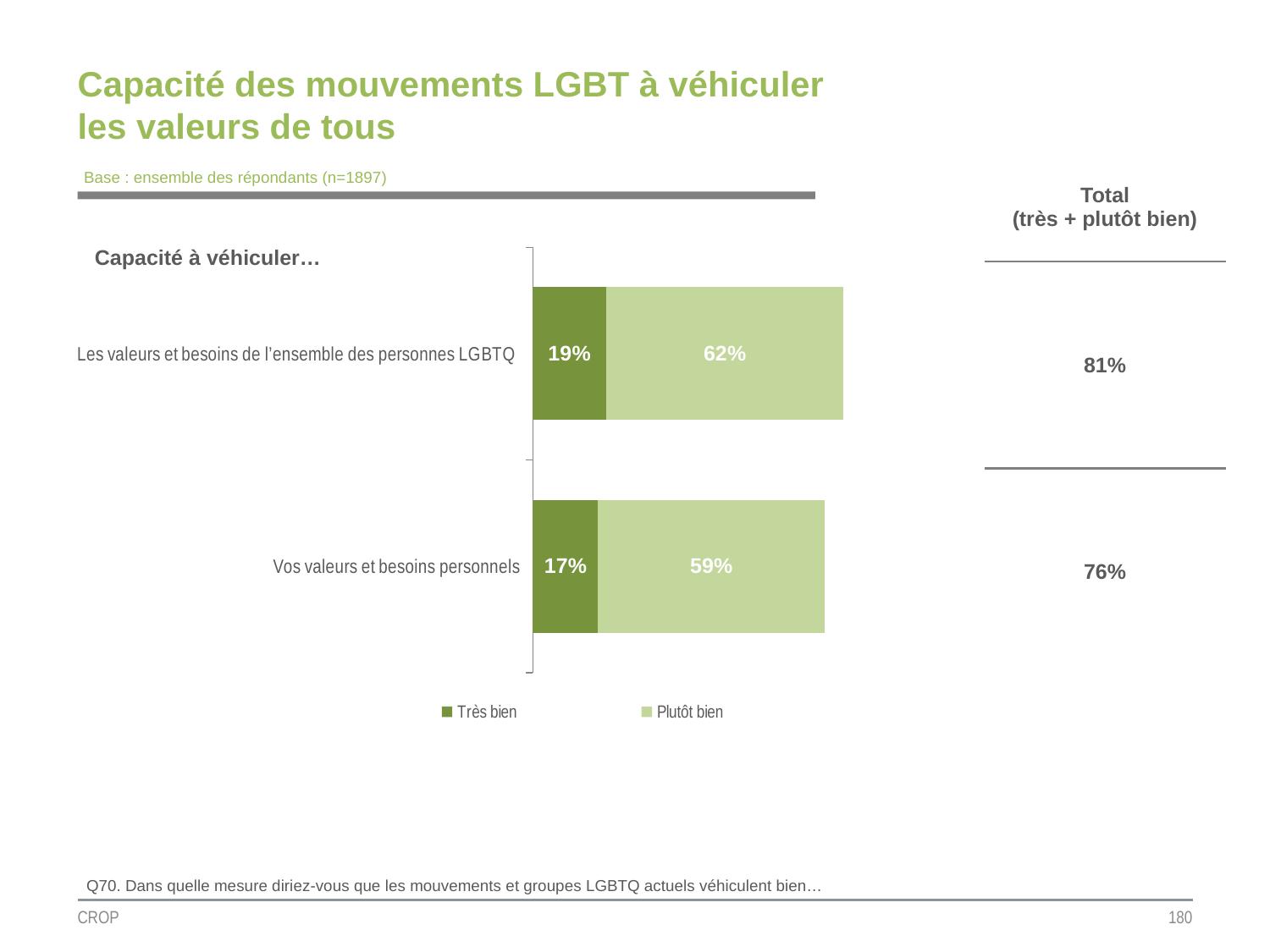
What is the 'Plutôt bien' value for 'Les valeurs et besoins de l'ensemble des personnes LGBTQ'? 62% What is the difference between the 'Plutôt bien' values of the two categories? 3 percentage points What is the total (très + plutôt bien) for 'Les valeurs et besoins de l'ensemble des personnes LGBTQ'? 81% How many categories are shown in the chart? 2 How many series does the legend list? 2 What is the 'Très bien' value for 'Les valeurs et besoins de l'ensemble des personnes LGBTQ'? 19% What is the total (très + plutôt bien) for 'Vos valeurs et besoins personnels'? 76% Is the 'Plutôt bien' value for 'Vos valeurs et besoins personnels' larger or smaller than the 'Plutôt bien' value for 'Les valeurs et besoins de l'ensemble des personnes LGBTQ'? smaller What kind of chart is shown on the slide? Stacked bar chart What is the 'Plutôt bien' value for 'Vos valeurs et besoins personnels'? 59% Which category has the higher 'Très bien' value? Les valeurs et besoins de l'ensemble des personnes LGBTQ What is the 'Très bien' value for 'Vos valeurs et besoins personnels'? 17%